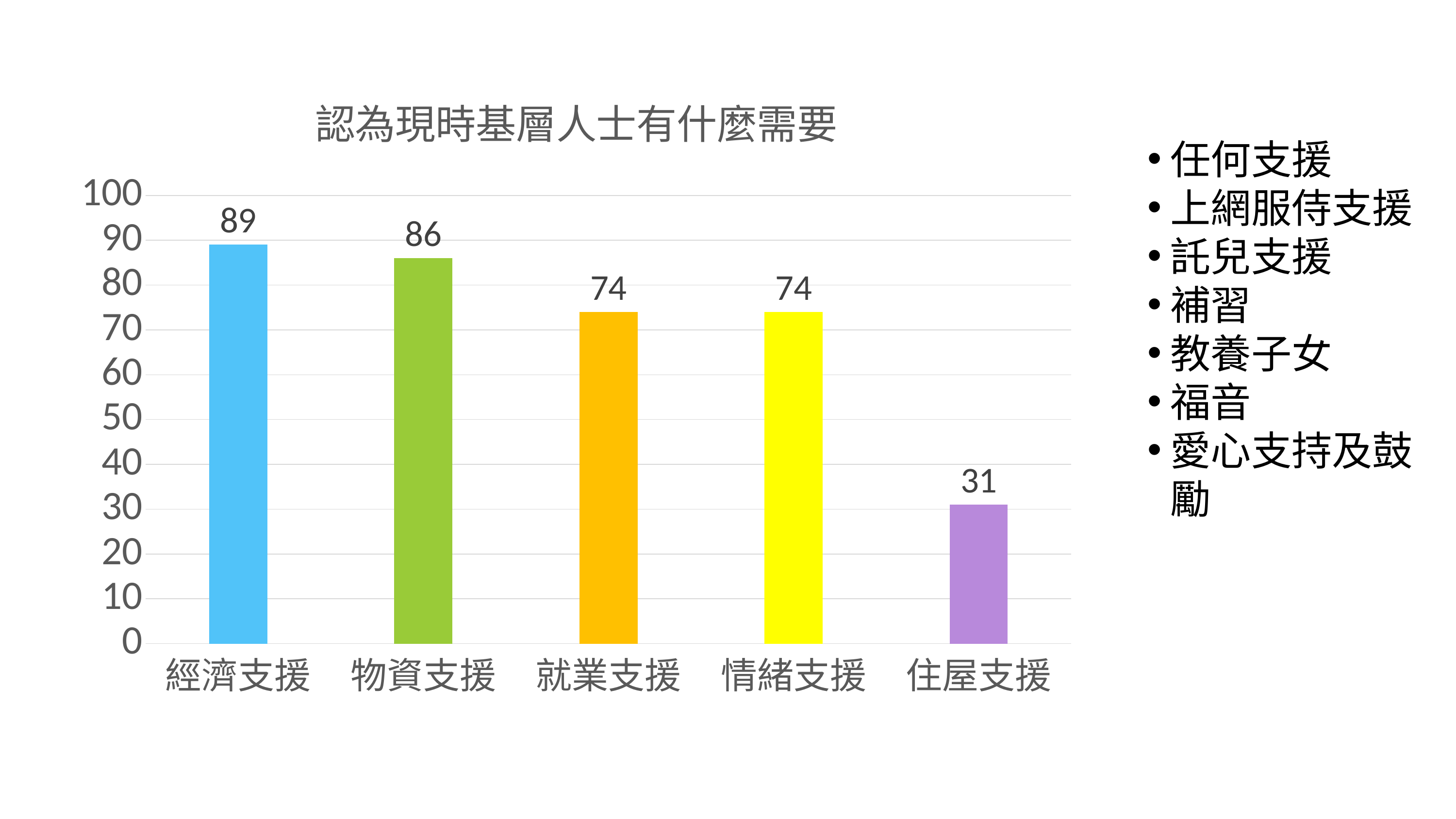
What is the title of the chart? 認為現時基層人士有什麼需要 What is the value for 經濟支援? 89 How many categories are shown in the chart? 5 What is the difference between the values for 經濟支援 and 住屋支援? 58 What is the value for 住屋支援? 31 What is the difference between the values for 物資支援 and 情緒支援? 12 What is the value for 就業支援? 74 What kind of chart is shown on the slide? Bar chart What is the value for 物資支援? 86 Which category has the lowest value? 住屋支援 Which category has the highest value? 經濟支援 Which is larger, the value for 物資支援 or the value for 就業支援? 物資支援